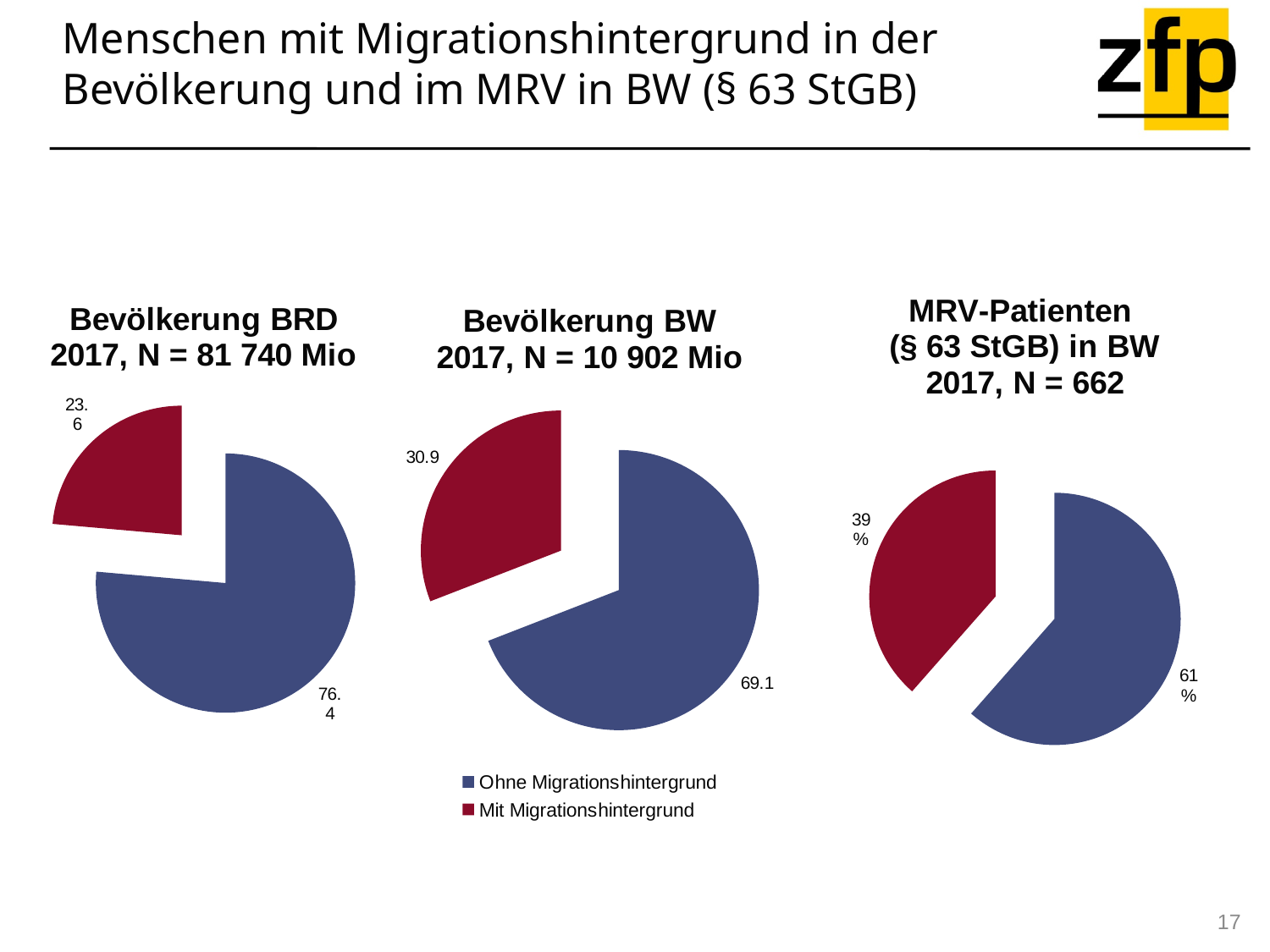
Which is larger: the 'Mit Migrationshintergrund' value in the 'Bevölkerung BW' chart or in the 'Bevölkerung BRD' chart? Bevölkerung BW What type of chart is used for the 'MRV-Patienten (§ 63 StGB) in BW 2017, N = 662' chart? Pie chart In the 'MRV-Patienten (§ 63 StGB) in BW 2017, N = 662' chart, what share is shown for 'Mit Migrationshintergrund'? 39% In the 'Bevölkerung BRD 2017, N = 81 740 Mio' chart, what value is shown for 'Ohne Migrationshintergrund'? 76.4 In the 'Bevölkerung BRD 2017, N = 81 740 Mio' chart, what is the difference between the 'Ohne Migrationshintergrund' and 'Mit Migrationshintergrund' values? 52.8 How many entries does the legend on the slide list? 2 In the 'Bevölkerung BRD 2017, N = 81 740 Mio' chart, which slice is the smallest? Mit Migrationshintergrund In the 'MRV-Patienten (§ 63 StGB) in BW 2017, N = 662' chart, what share is shown for 'Ohne Migrationshintergrund'? 61% In the 'Bevölkerung BW 2017, N = 10 902 Mio' chart, what value is shown for 'Mit Migrationshintergrund'? 30.9 In the 'Bevölkerung BW 2017, N = 10 902 Mio' chart, what value is shown for 'Ohne Migrationshintergrund'? 69.1 In the 'Bevölkerung BRD 2017, N = 81 740 Mio' chart, what value is shown for 'Mit Migrationshintergrund'? 23.6 In the 'Bevölkerung BW 2017, N = 10 902 Mio' chart, which slice is the largest? Ohne Migrationshintergrund